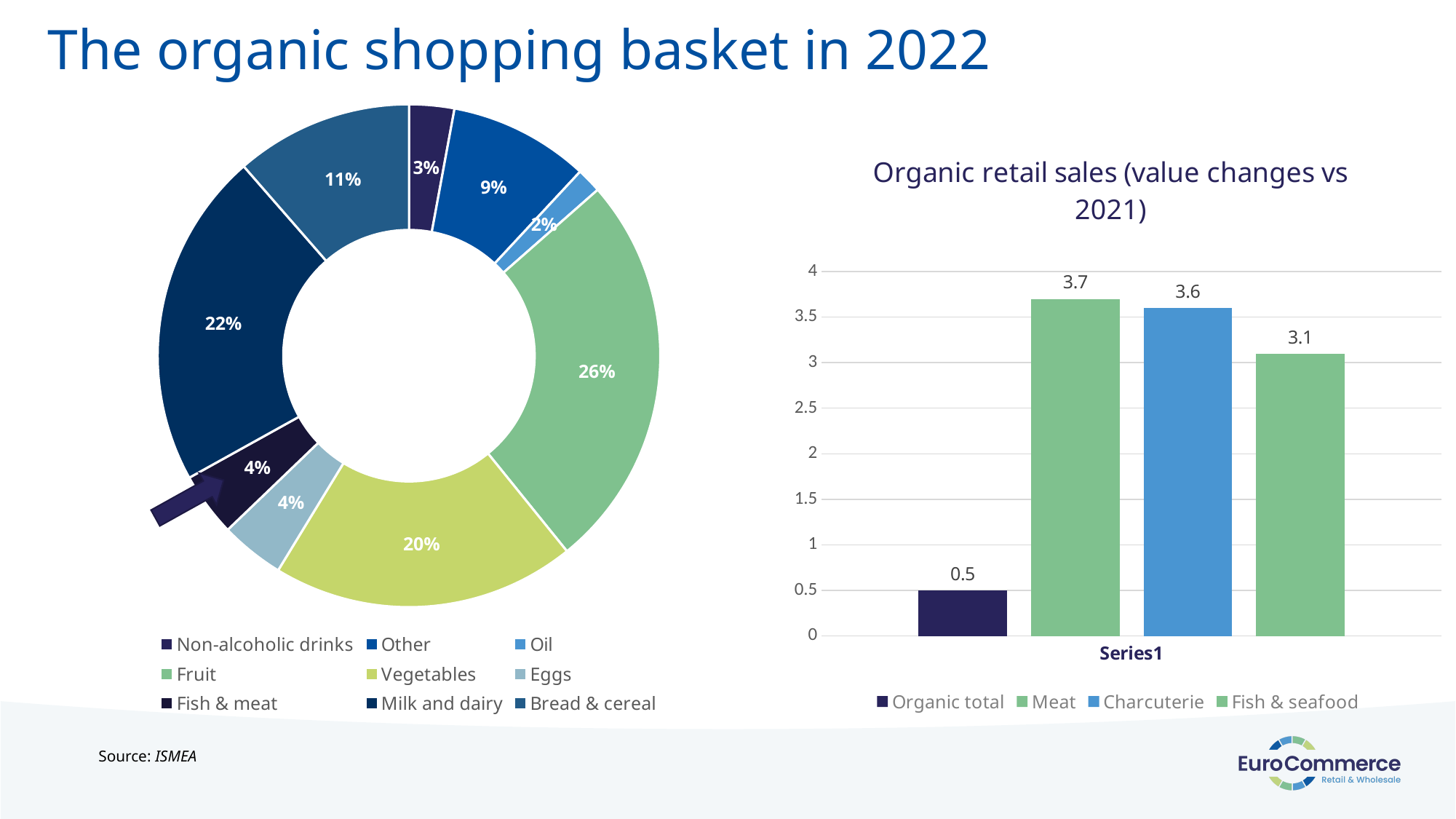
In the donut chart on the left, which category has the largest share? Fruit In the donut chart on the left, what share does Fruit have? 26% In the donut chart on the left, what share does Milk and dairy have? 22% In the bar chart titled 'Organic retail sales (value changes vs 2021)', which series has the lowest value? Organic total In the donut chart on the left, which is larger: Vegetables or Bread & cereal? Vegetables In the donut chart on the left, which category has the smallest share? Oil In the donut chart on the left, what is the difference between the shares of Fruit and Vegetables? 6% In the bar chart titled 'Organic retail sales (value changes vs 2021)', what is the value for Meat? 3.7 In the bar chart titled 'Organic retail sales (value changes vs 2021)', what is the value for Organic total? 0.5 How many series does the legend of the bar chart on the right list? 4 In the bar chart titled 'Organic retail sales (value changes vs 2021)', what is the difference between Meat and Fish & seafood? 0.6 How many categories does the legend of the donut chart on the left list? 9